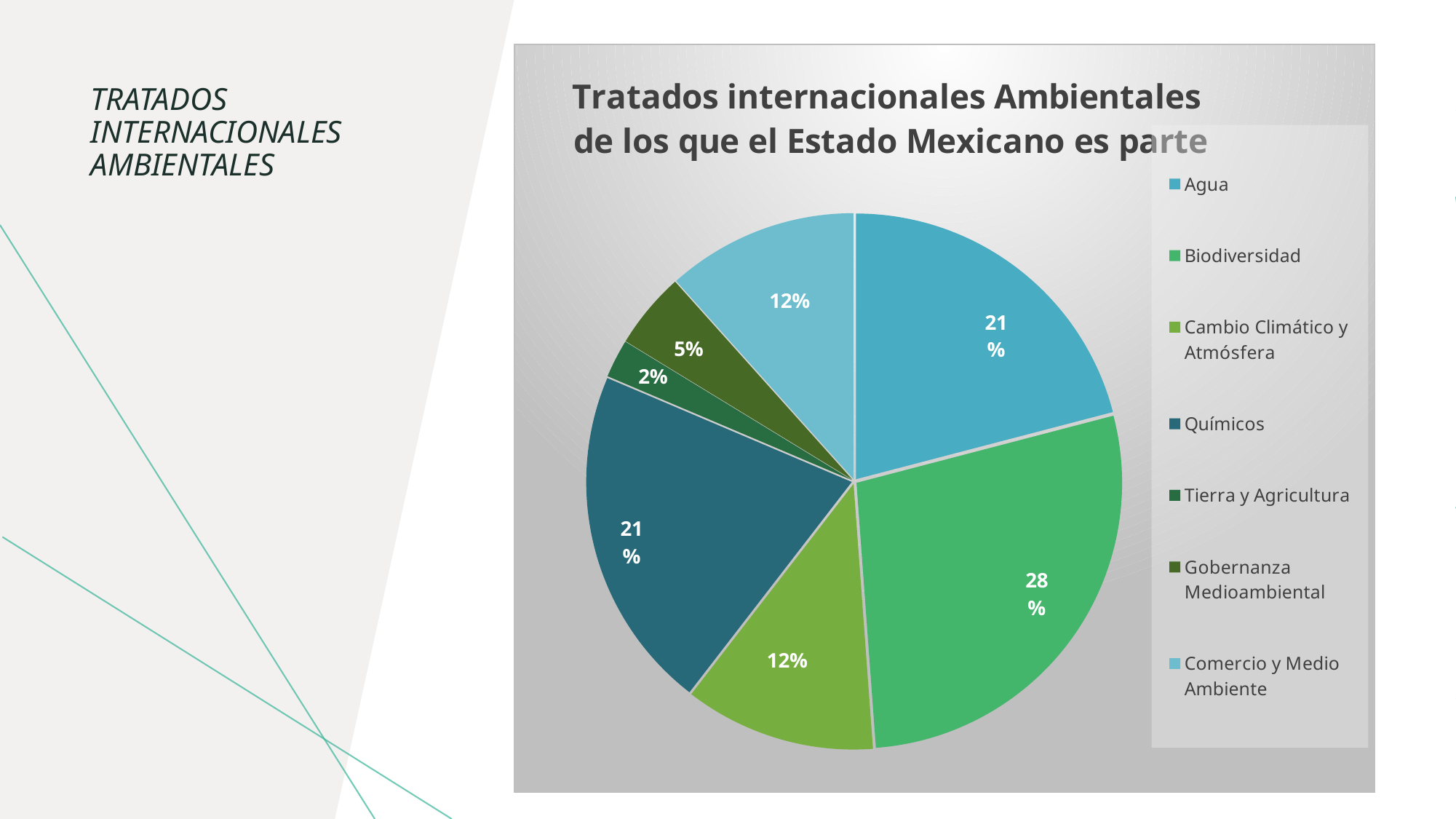
What is the title of the chart? Tratados internacionales Ambientales de los que el Estado Mexicano es parte What share of the pie does Tierra y Agricultura represent? 2% Which category has the smallest slice of the pie? Tierra y Agricultura How many categories does the legend list? 7 What share of the pie does Biodiversidad represent? 28% What share of the pie does Agua represent? 21% What is the difference in percentage points between Biodiversidad and Gobernanza Medioambiental? 23 Which is larger, the slice for Cambio Climático y Atmósfera or the slice for Gobernanza Medioambiental? Cambio Climático y Atmósfera What kind of chart is shown on the slide? pie chart Which category has the largest slice of the pie? Biodiversidad